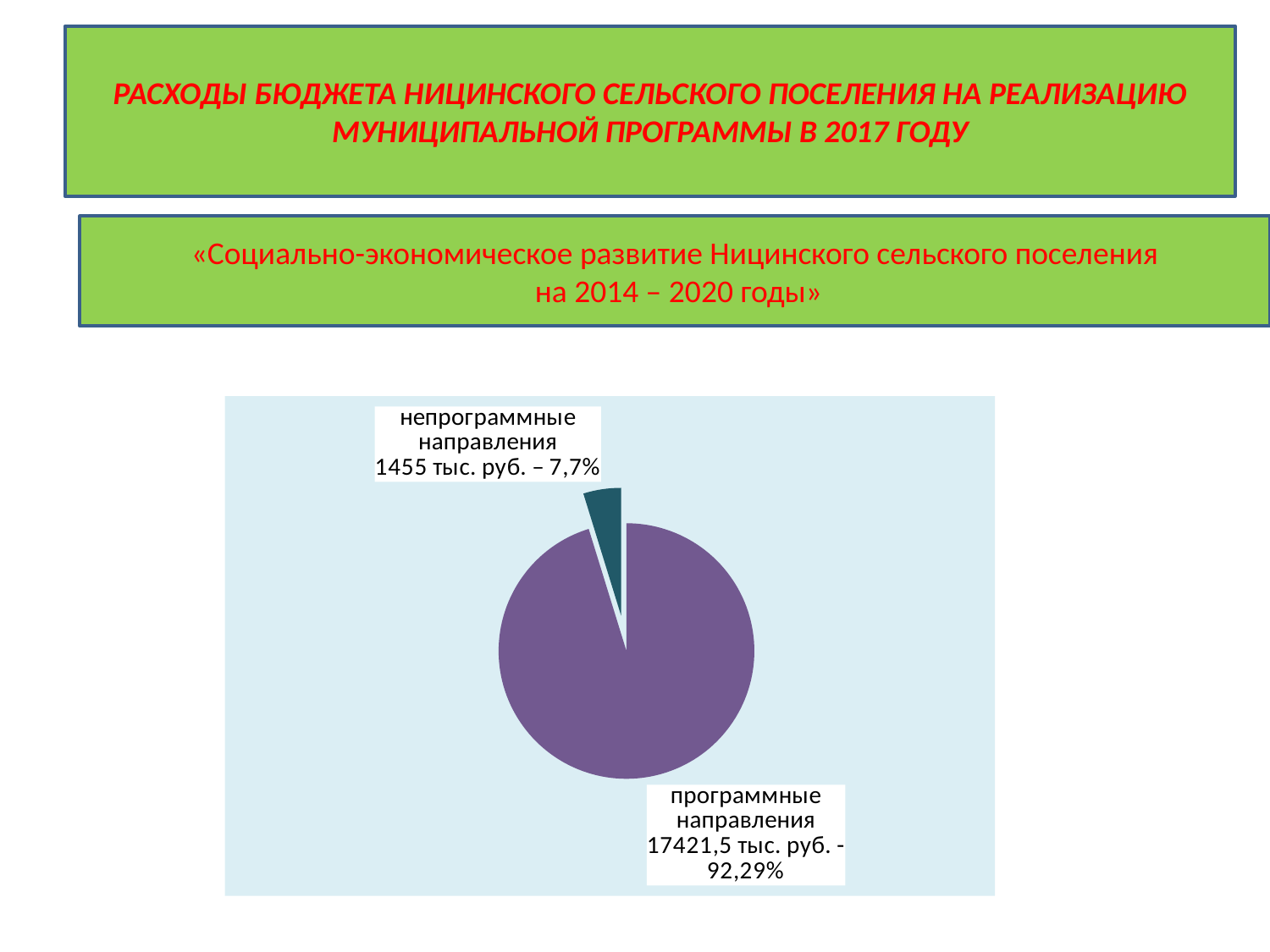
How many slices does the pie chart have? 2 What share of the pie does «непрограммные направления» represent? 7,7% Which slice of the pie chart is the largest? программные направления What is the value for «непрограммные направления» in the pie chart? 1455 тыс. руб. What colour is the slice for «непрограммные направления»? dark teal What is the value for «программные направления» in the pie chart? 17421,5 тыс. руб. Which is larger: «программные направления» or «непрограммные направления»? программные направления What share of the pie does «программные направления» represent? 92,29% What is the difference between the values for «программные направления» and «непрограммные направления»? 15966,5 тыс. руб. What is the total of the two values shown in the pie chart? 18876,5 тыс. руб. What kind of chart is shown on the slide? pie chart Which slice of the pie chart is the smallest? непрограммные направления